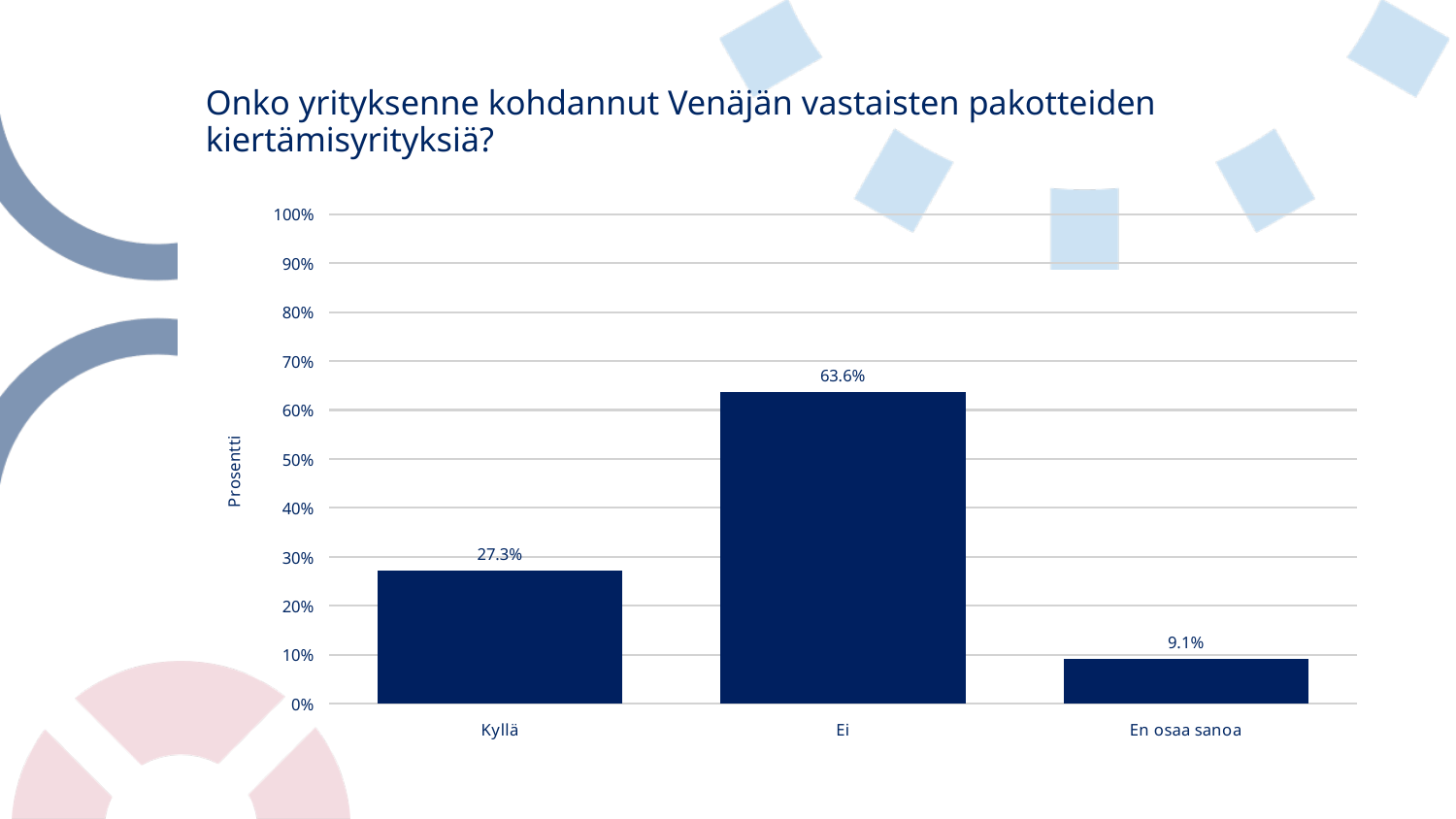
What is the difference between the values for Kyllä and En osaa sanoa? 18.2% What is the value for Ei? 63.6% What is the value for Kyllä? 27.3% What kind of chart is shown on the slide? bar chart Is the value for Ei greater or less than 50%? greater How many categories are shown on the x axis? 3 Which category has the lowest value? En osaa sanoa Which is larger, the value for Kyllä or the value for Ei? Ei What is the value for En osaa sanoa? 9.1% What is the difference between the values for Ei and Kyllä? 36.3% What is the label of the y axis? Prosentti Which category has the highest value? Ei